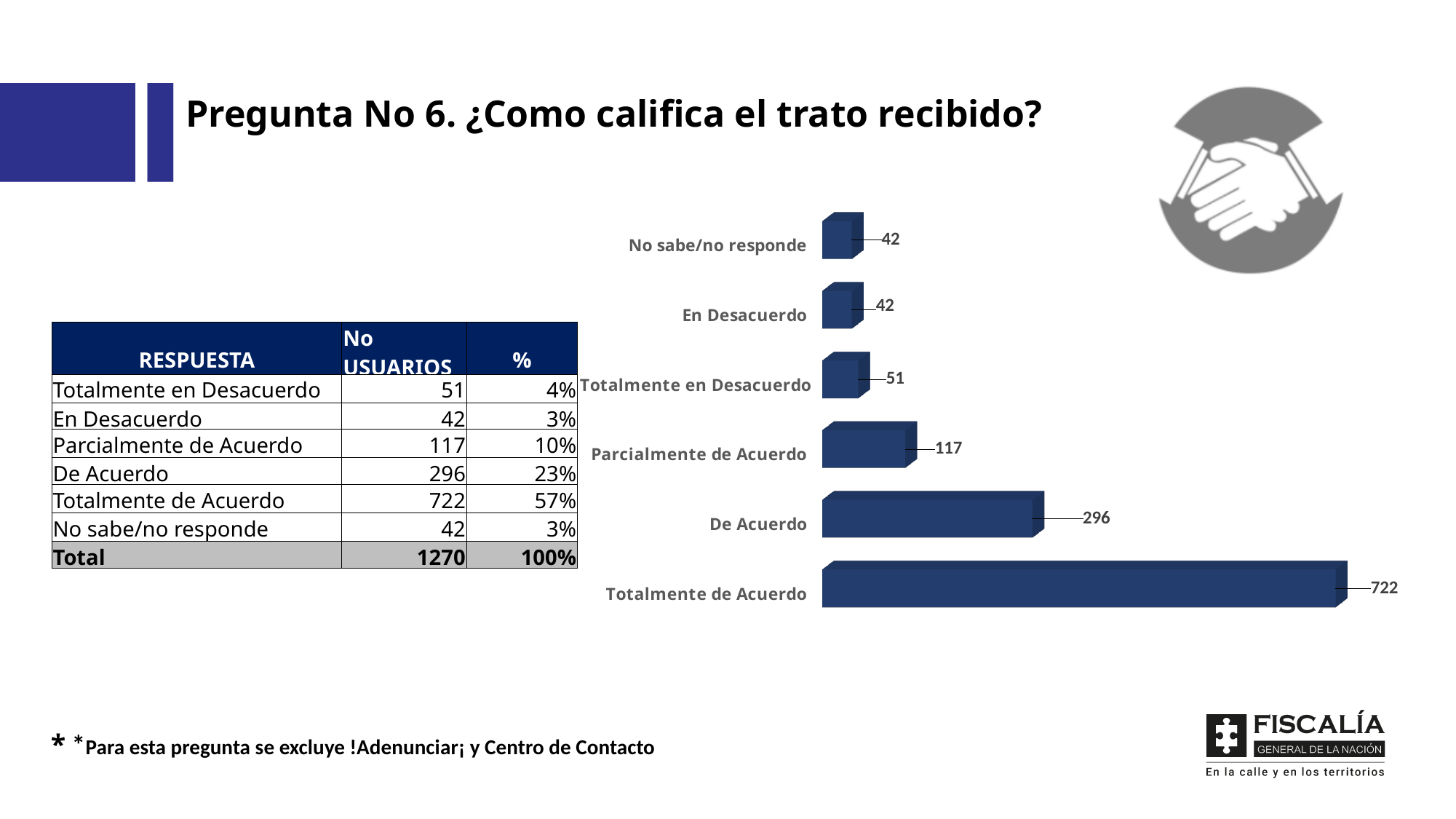
What is the value for De Acuerdo in the bar chart? 296 Which two categories in the bar chart share the same value of 42? No sabe/no responde and En Desacuerdo What kind of chart is shown on the slide? bar chart What is the value for Totalmente en Desacuerdo in the bar chart? 51 What is the difference between the values for Totalmente de Acuerdo and De Acuerdo? 426 What colour are the bars in the chart? dark blue What is the difference between the values for Totalmente en Desacuerdo and En Desacuerdo? 9 Which is larger in the bar chart: Parcialmente de Acuerdo or Totalmente en Desacuerdo? Parcialmente de Acuerdo What is the value for Parcialmente de Acuerdo in the bar chart? 117 What is the value for Totalmente de Acuerdo in the bar chart? 722 Which category has the highest value in the bar chart? Totalmente de Acuerdo How many categories are shown in the bar chart? 6